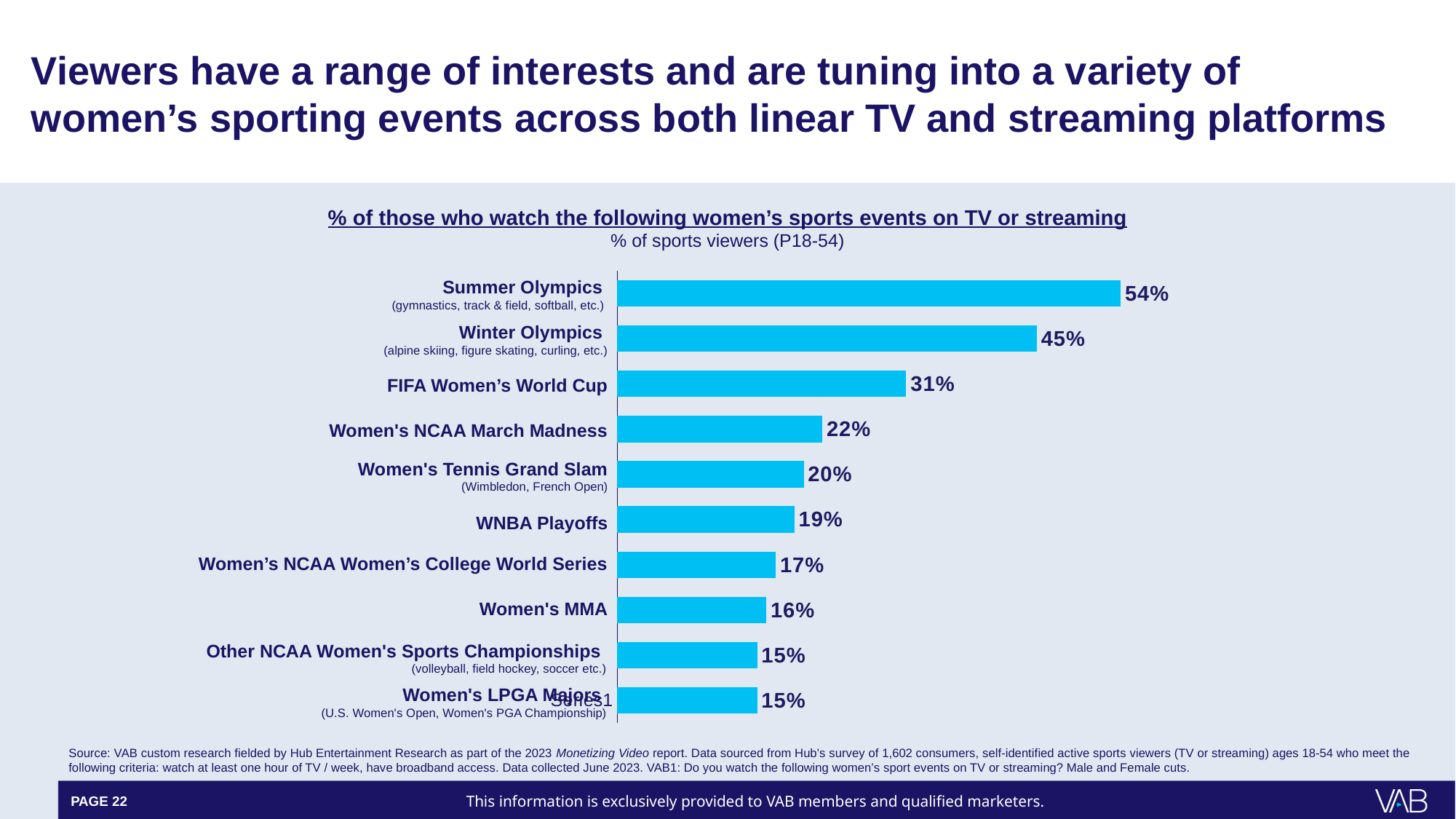
What is the value shown for the FIFA Women's World Cup? 31% Which event has the highest percentage of sports viewers? Summer Olympics What is the difference between Women's NCAA March Madness and Women's Tennis Grand Slam? 2 What is the value for Women's MMA? 16% What percentage of sports viewers watch the Summer Olympics women's events on TV or streaming? 54% What percentage is shown for WNBA Playoffs? 19% What is the subtitle shown under the chart title? % of sports viewers (P18-54) Which has a larger value, Women's NCAA Women's College World Series or Women's MMA? Women's NCAA Women's College World Series Which has a larger value, FIFA Women's World Cup or Women's NCAA March Madness? FIFA Women's World Cup What type of chart is shown on the slide? Bar chart How many women's sports events are listed in the chart? 10 What is the difference in percentage points between the Summer Olympics and the Winter Olympics? 9